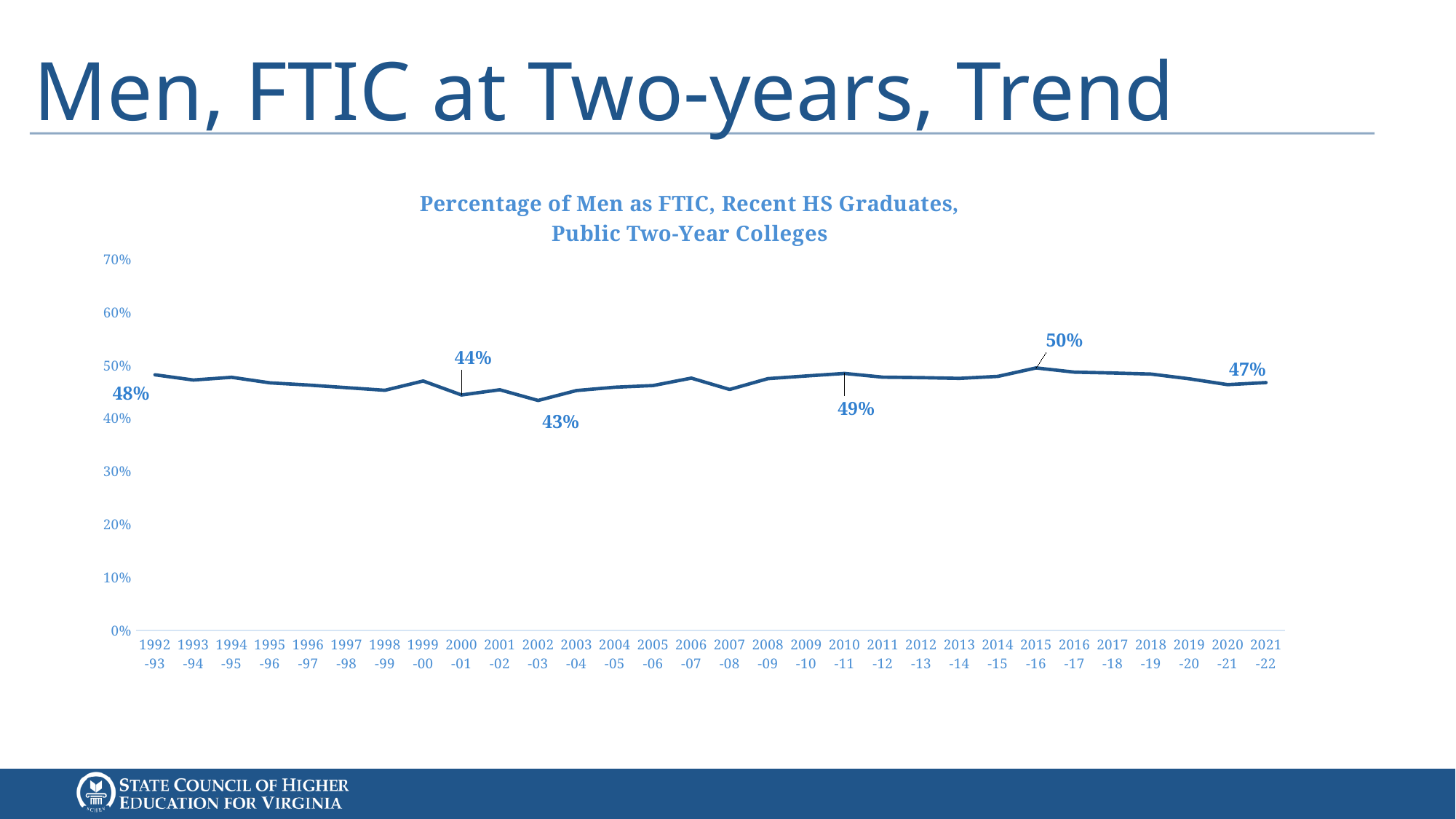
What is the value shown for 2002-03? 43% What kind of chart is shown on the slide? Line chart What is the value shown for 2015-16? 50% What is the value shown for 2000-01? 44% What is the value shown for 2010-11? 49% How many academic years are plotted on the x axis? 30 What is the difference between the 2015-16 value and the 2002-03 value? 7 percentage points Among the labeled points, which year has the highest value? 2015-16 Is the value for 2015-16 greater or less than 40%? greater Among the labeled points, which year has the lowest value? 2002-03 What is the percentage of men as FTIC at public two-year colleges in 1992-93? 48% What is the value shown for 2021-22? 47%